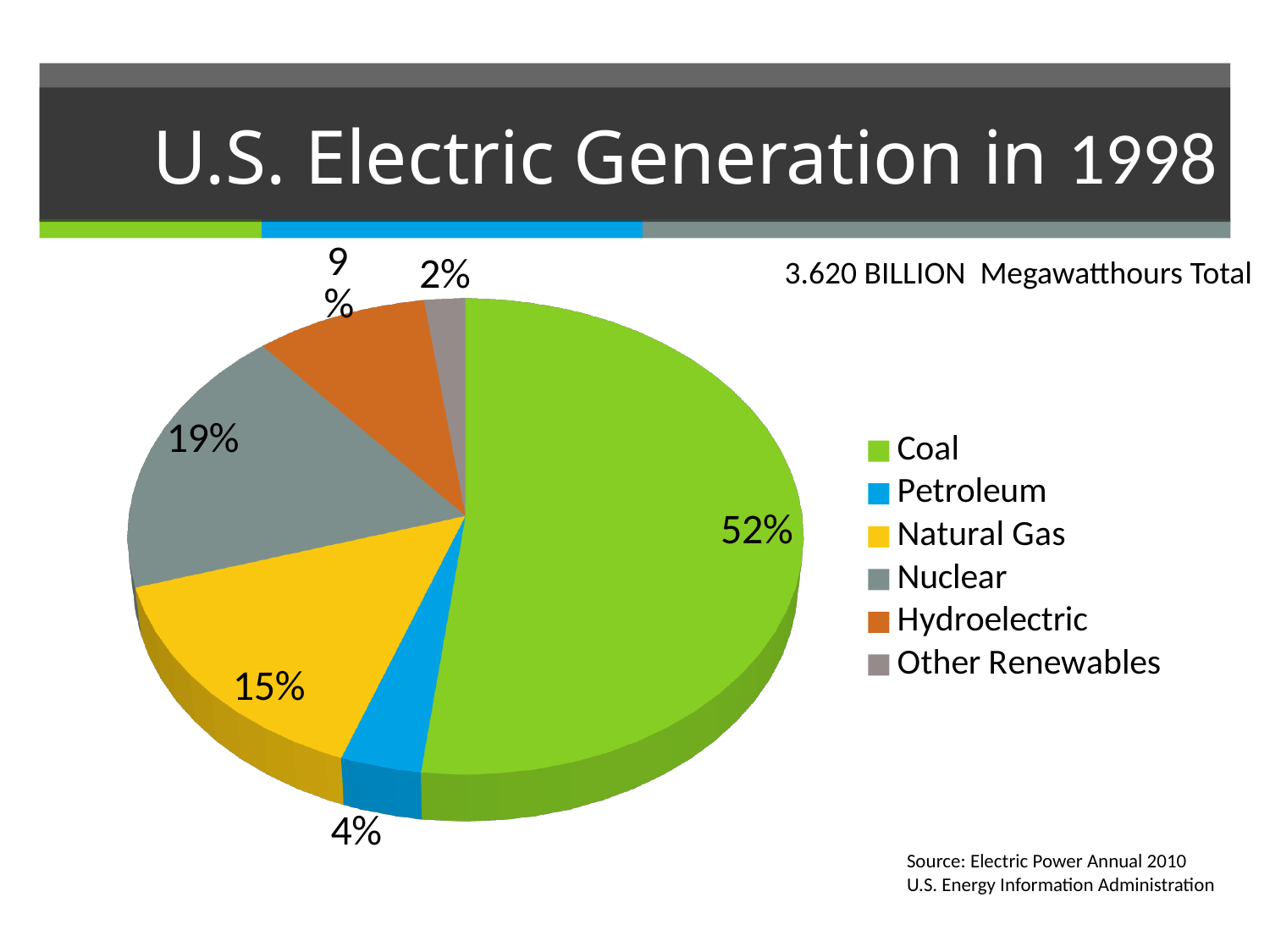
Which source has the smallest share of the pie? Other Renewables What share of U.S. electric generation in 1998 came from Petroleum? 4% What share of U.S. electric generation in 1998 came from Coal? 52% What share of U.S. electric generation in 1998 came from Natural Gas? 15% What share of U.S. electric generation in 1998 came from Nuclear? 19% What is the difference in percentage points between the Coal share and the Nuclear share? 33 Which source has the largest share of the pie? Coal What share of U.S. electric generation in 1998 came from Other Renewables? 2% What total generation is stated on the slide? 3.620 BILLION Megawatthours How many categories does the legend list? 6 What kind of chart is shown on the slide? Pie chart Which has a larger share, Natural Gas or Hydroelectric? Natural Gas